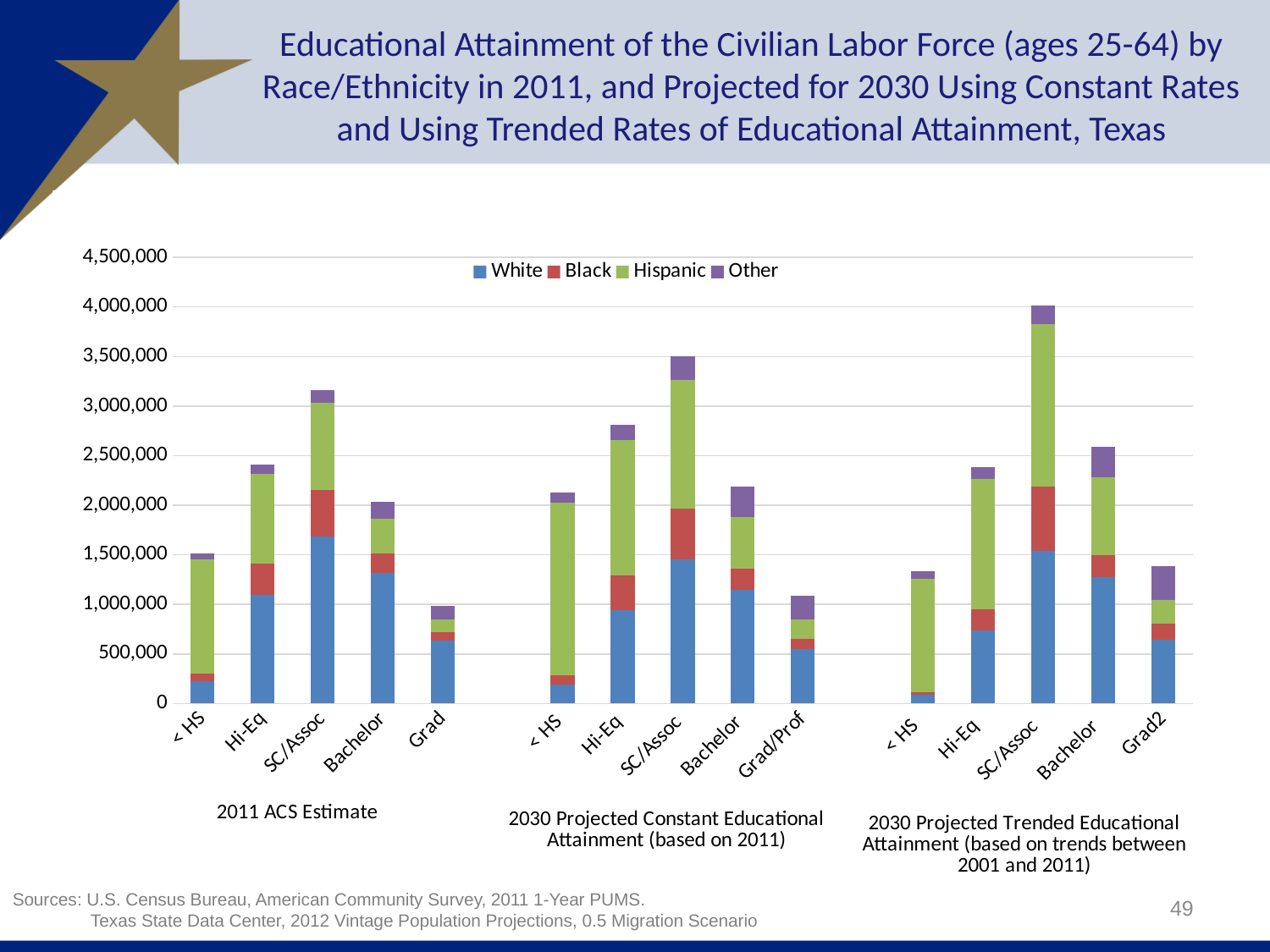
Within the 2011 ACS Estimate group, which category has the tallest bar? SC/Assoc Which is larger: the Bachelor bar in the 2030 Projected Constant group or the Bachelor bar in the 2030 Projected Trended group? 2030 Projected Trended Which bar is the tallest on the whole chart? SC/Assoc in the 2030 Projected Trended Educational Attainment group Which is larger: the < HS bar in the 2011 ACS Estimate group or the < HS bar in the 2030 Projected Constant Educational Attainment group? 2030 Projected Constant Educational Attainment Is the total for Hi-Eq in the 2030 Projected Constant Educational Attainment group greater or less than 2,500,000? greater Which series is shown in blue at the bottom of each stacked bar? White Is the total for SC/Assoc in the 2030 Projected Trended Educational Attainment group greater or less than 3,500,000? greater Which bar is the shortest on the whole chart? Grad in the 2011 ACS Estimate group How many series does the legend list? 4 How many bars are plotted in total across the three groups? 15 What kind of chart is shown on the slide? Stacked bar chart